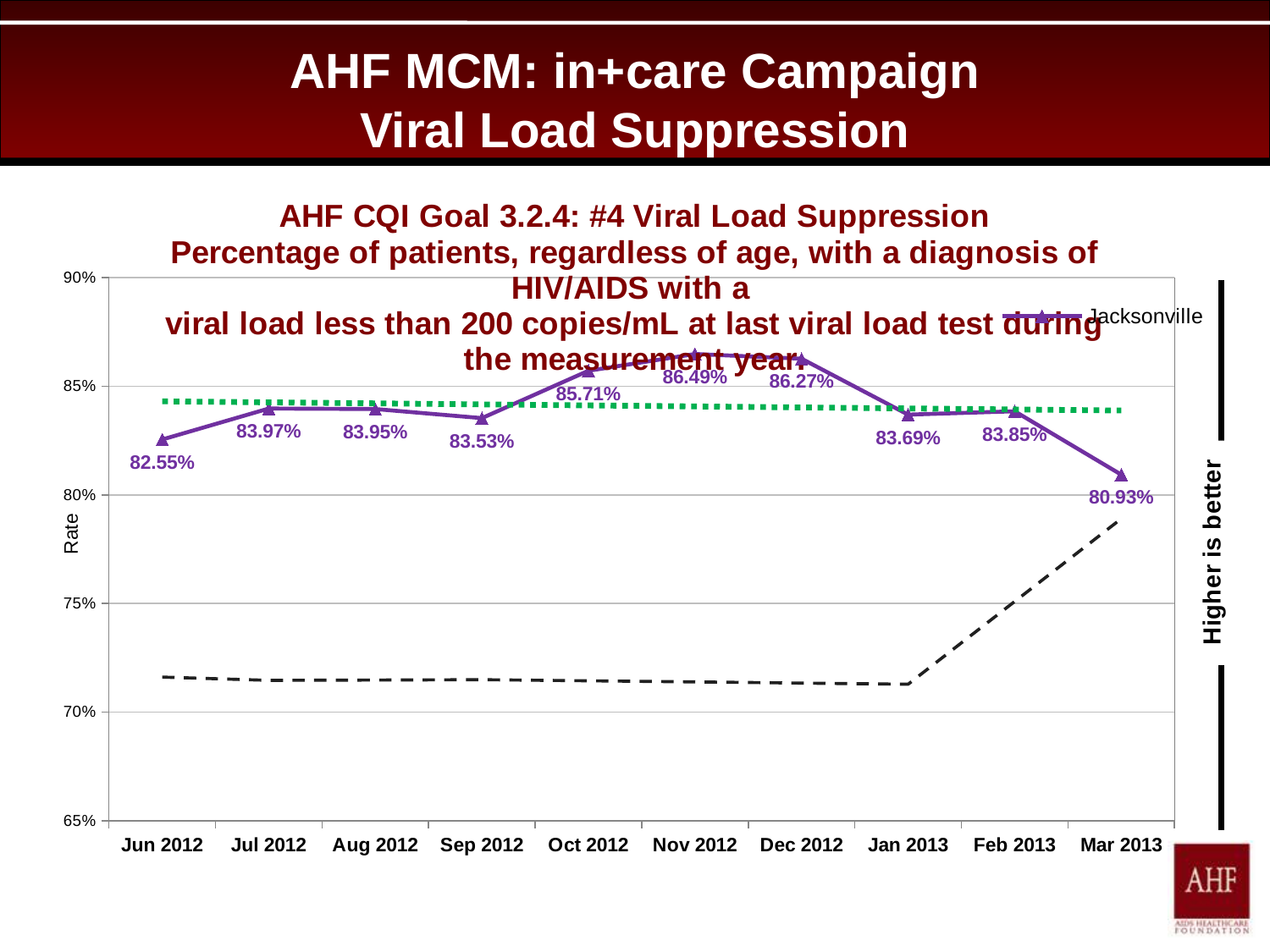
What type of chart is shown on the slide? Line chart What is the difference between the Jacksonville value in Nov 2012 and in Jun 2012? 3.94 percentage points Is the Jacksonville value for Feb 2013 greater or less than 85%? less What is the viral load suppression rate for Jacksonville in Oct 2012? 85.71% What is the viral load suppression rate for Jacksonville in Mar 2013? 80.93% In which month does the Jacksonville series reach its highest value? Nov 2012 Which is larger, the Jacksonville value in Dec 2012 or in Jan 2013? Dec 2012 How many series does the legend list? 1 In which month does the Jacksonville series reach its lowest value? Mar 2013 How many months are plotted on the x axis? 10 What is the viral load suppression rate for Jacksonville in Jun 2012? 82.55% What is the name of the series shown in the legend? Jacksonville